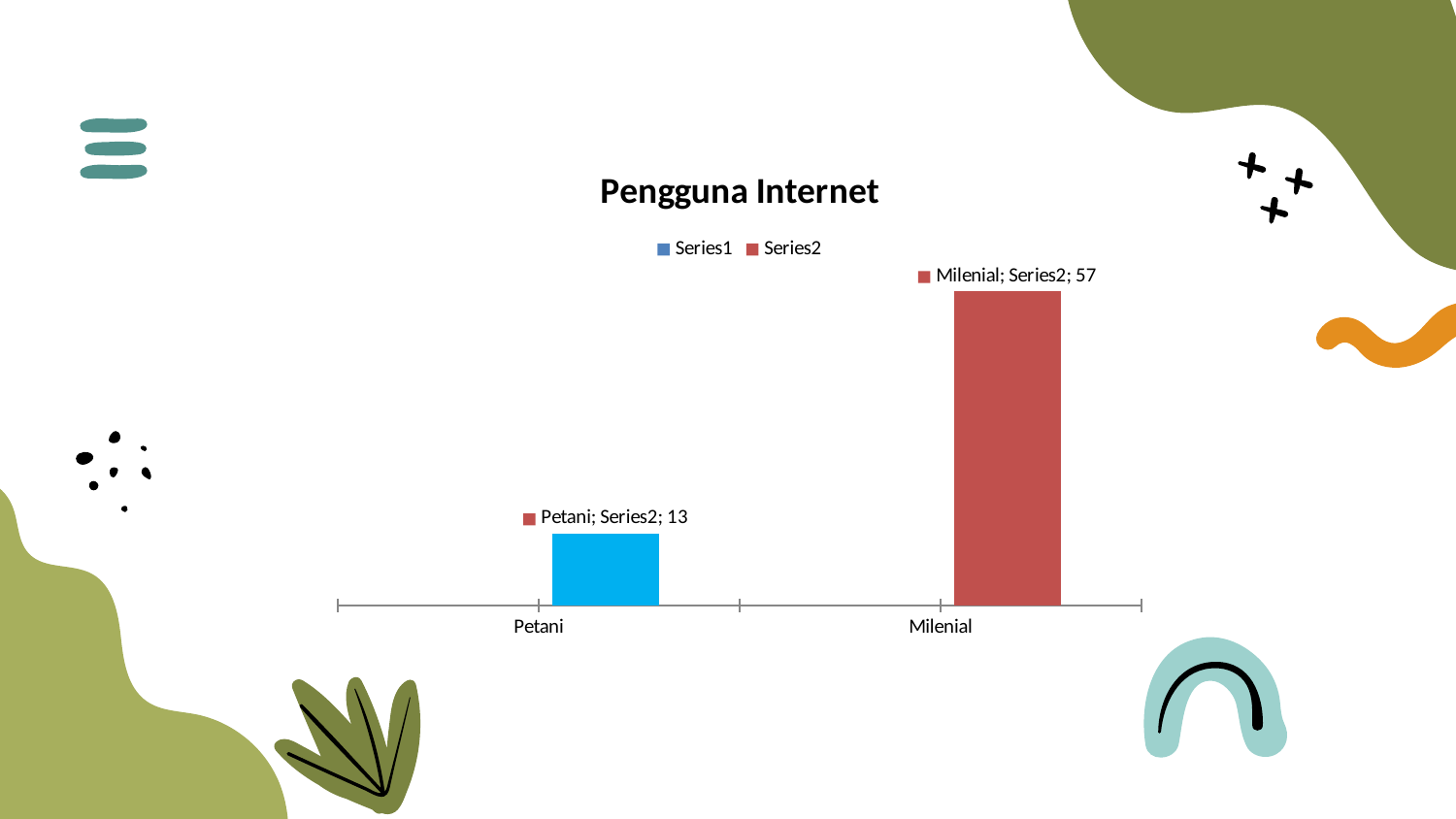
Which is larger, the value for Petani or the value for Milenial? Milenial How many categories are shown on the x axis of the chart? 2 What is the difference between the values for Milenial and Petani? 44 Which category has the highest value in the Pengguna Internet chart? Milenial Do the values rise or fall from Petani to Milenial along the x axis? Rise How many series does the legend list? 2 What is the value for Milenial in the Pengguna Internet chart? 57 What is the title of the chart? Pengguna Internet Which category has the lowest value in the Pengguna Internet chart? Petani What kind of chart is shown on the slide? Bar chart What is the value for Petani in the Pengguna Internet chart? 13 What are the two series names listed in the legend? Series1 and Series2